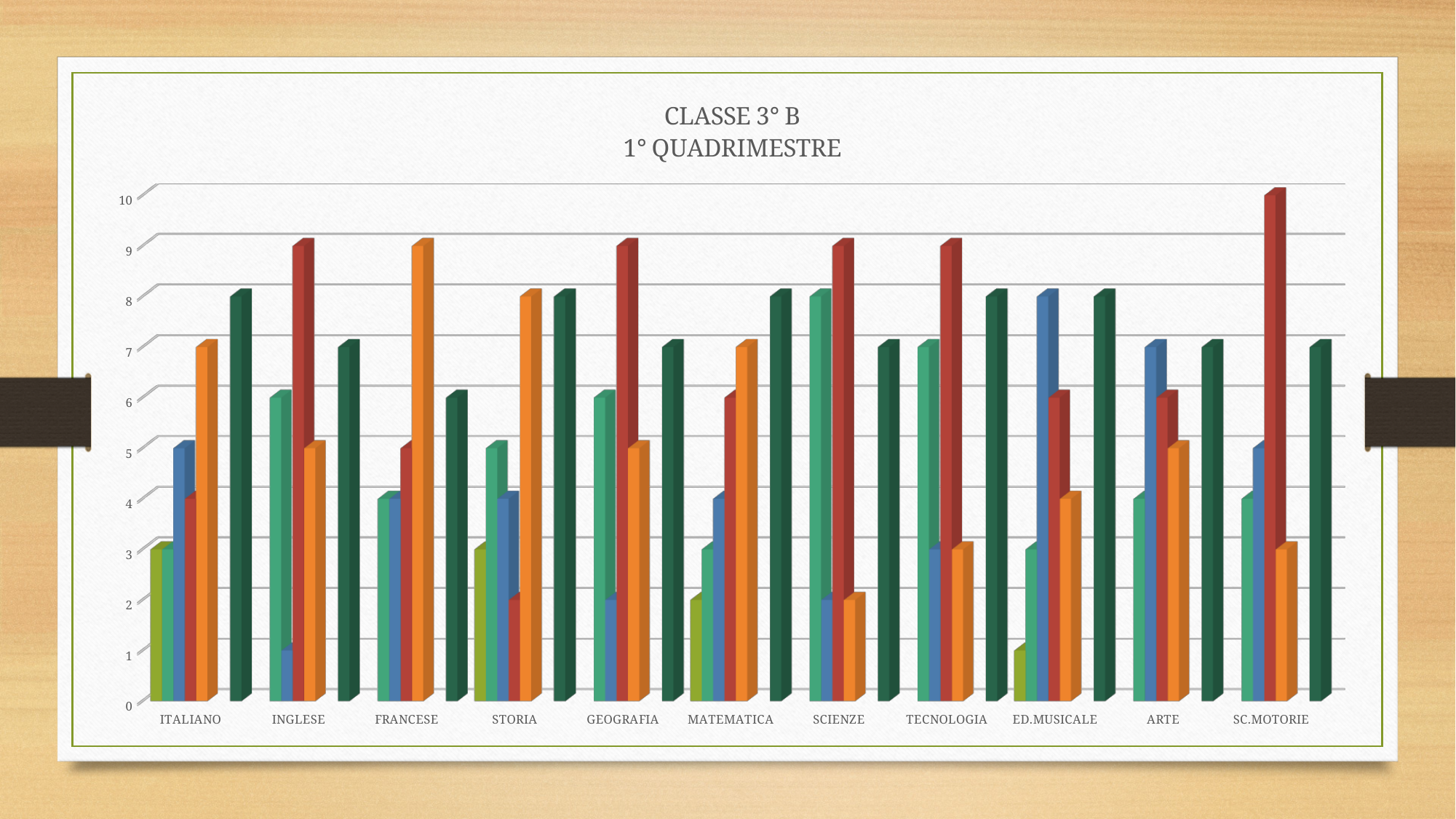
What is the value of the dark green bar for ITALIANO? 8 Is the orange bar for SC.MOTORIE greater or less than 5? less What is the value of the orange bar for FRANCESE? 9 What is the difference between the red bar for INGLESE (9) and the blue bar for INGLESE (1)? 8 Which is larger for ED.MUSICALE, the blue bar or the orange bar? the blue bar What kind of chart is shown on the slide? bar chart What is the title of the chart? CLASSE 3° B 1° QUADRIMESTRE Which subject has the tallest bar in the chart? SC.MOTORIE What is the value of the blue bar for INGLESE? 1 What is the value of the tallest bar in the chart (the red bar for SC.MOTORIE)? 10 Is the red bar for SCIENZE greater or less than 8? greater How many subject categories are shown on the x axis? 11